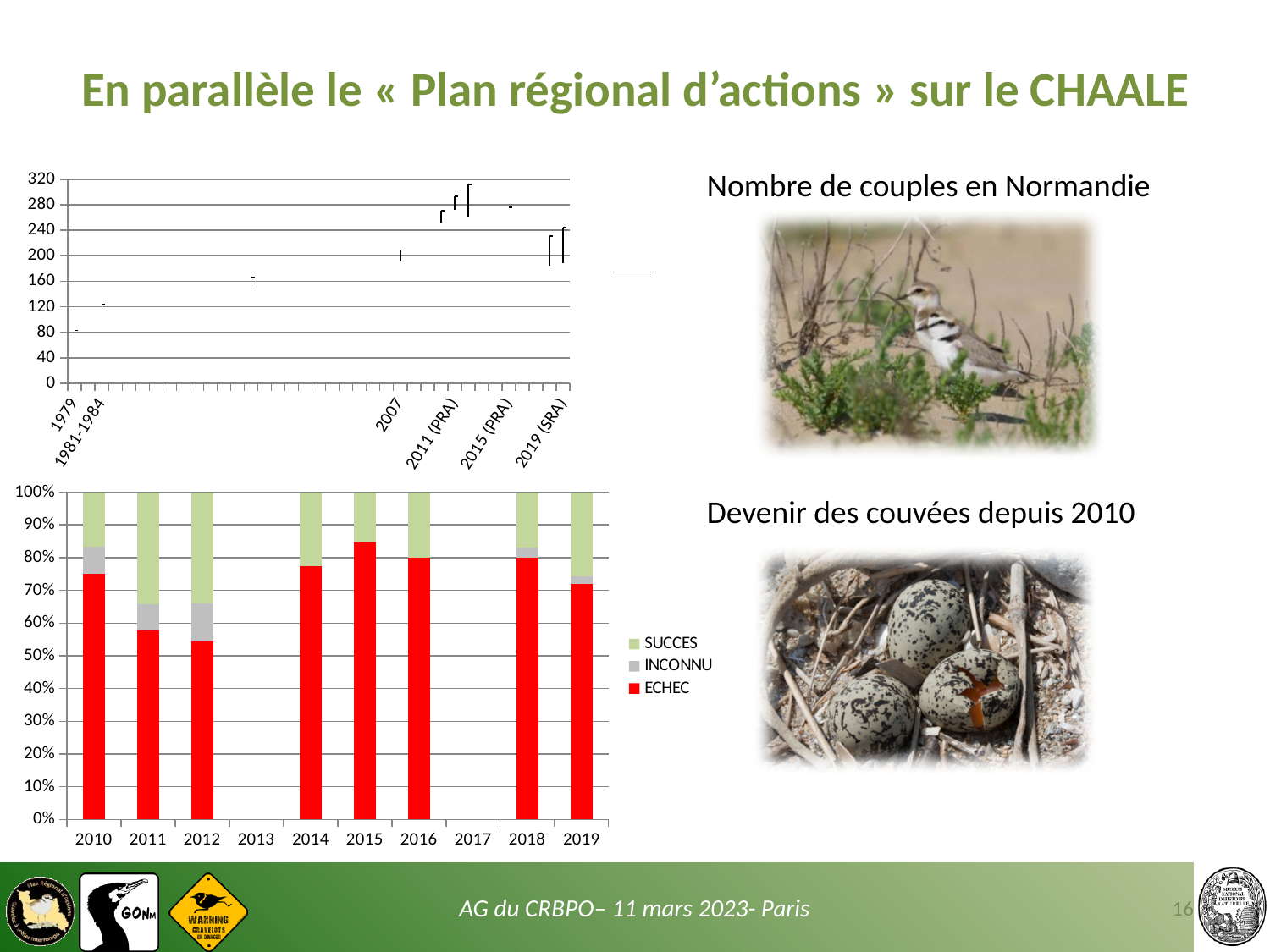
In the bottom chart 'Devenir des couvées depuis 2010', which year has the highest ECHEC share? 2015 In the bottom chart 'Devenir des couvées depuis 2010', is the SUCCES share larger in 2012 or in 2015? 2012 In the bottom chart 'Devenir des couvées depuis 2010', how many years are labelled on the x axis? 10 In the bottom chart 'Devenir des couvées depuis 2010', is the ECHEC share for 2015 greater or less than 80%? greater In the bottom chart 'Devenir des couvées depuis 2010', which colour represents ECHEC? red What kind of chart is the bottom chart, 'Devenir des couvées depuis 2010'? stacked bar chart In the bottom chart 'Devenir des couvées depuis 2010', is the ECHEC share for 2011 greater or less than 60%? less In the bottom chart 'Devenir des couvées depuis 2010', which year has the lowest ECHEC share? 2012 In the bottom chart 'Devenir des couvées depuis 2010', which years have no bar plotted? 2013 and 2017 In the top chart 'Nombre de couples en Normandie', what is the maximum value shown on the y axis? 320 How many series does the legend of the bottom chart 'Devenir des couvées depuis 2010' list? 3